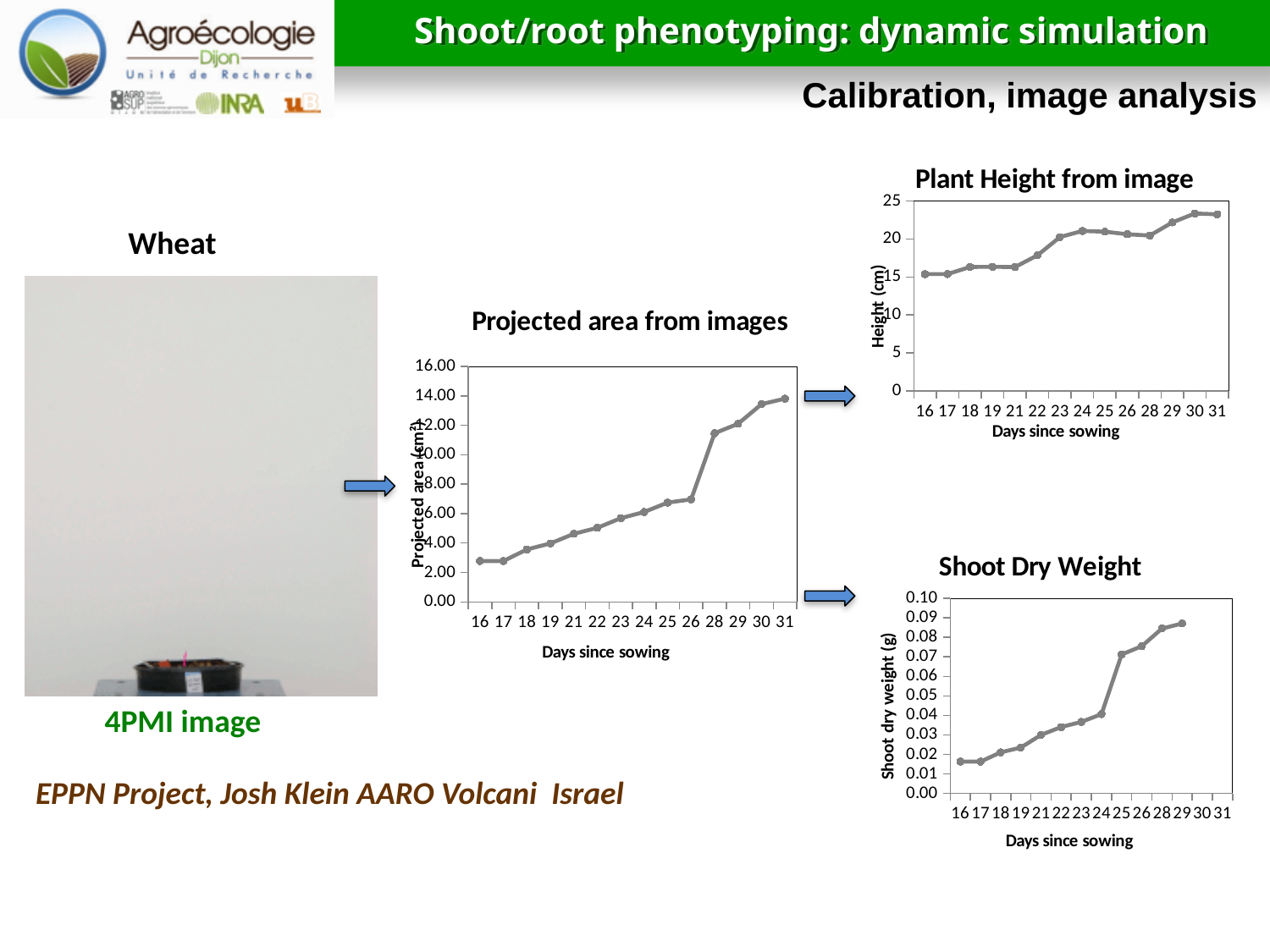
In the 'Shoot Dry Weight' chart, is the value at day 16 greater or less than 0.02? less In the 'Projected area from images' chart, how many data points are plotted along the x axis? 14 In the 'Shoot Dry Weight' chart, is the value at day 29 greater or less than 0.08? greater In the 'Projected area from images' chart, do the values rise or fall as days since sowing increase? rise In the 'Plant Height from image' chart, is the height at day 31 greater or less than 20? greater In the 'Projected area from images' chart, which is larger, the value at day 26 or the value at day 28? day 28 In the 'Projected area from images' chart, which day since sowing has the highest projected area? 31 What is the y-axis title of the 'Plant Height from image' chart? Height (cm) What kind of chart is the 'Projected area from images' chart? line chart